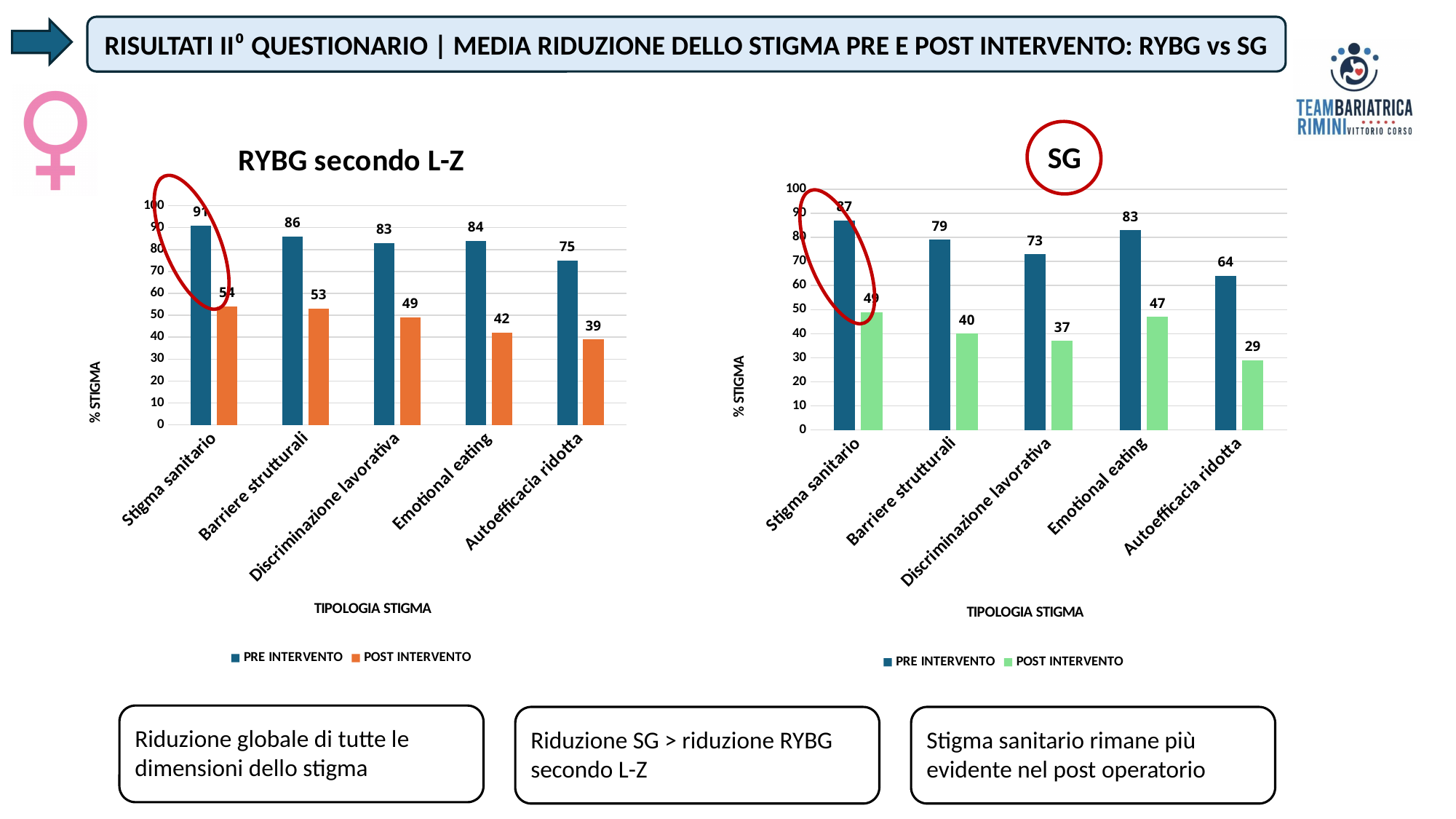
In the SG chart, is the PRE INTERVENTO value for Stigma sanitario greater or less than 80? greater In the SG chart, what is the difference between the PRE INTERVENTO and POST INTERVENTO values for Barriere strutturali? 39 In the SG chart, what is the POST INTERVENTO value for Autoefficacia ridotta? 29 In the RYBG secondo L-Z chart, what is the POST INTERVENTO value for Emotional eating? 42 In the RYBG secondo L-Z chart, what is the PRE INTERVENTO value for Barriere strutturali? 86 In the RYBG secondo L-Z chart, which category has the highest PRE INTERVENTO value? Stigma sanitario How many categories are shown on the x axis of the RYBG secondo L-Z chart? 5 In the SG chart, is the POST INTERVENTO value for Emotional eating larger or smaller than the POST INTERVENTO value for Discriminazione lavorativa? larger In the RYBG secondo L-Z chart, what is the difference between the PRE INTERVENTO and POST INTERVENTO values for Autoefficacia ridotta? 36 What type of chart is the SG chart? bar chart In the SG chart, what is the PRE INTERVENTO value for Discriminazione lavorativa? 73 In the SG chart, which category has the lowest POST INTERVENTO value? Autoefficacia ridotta